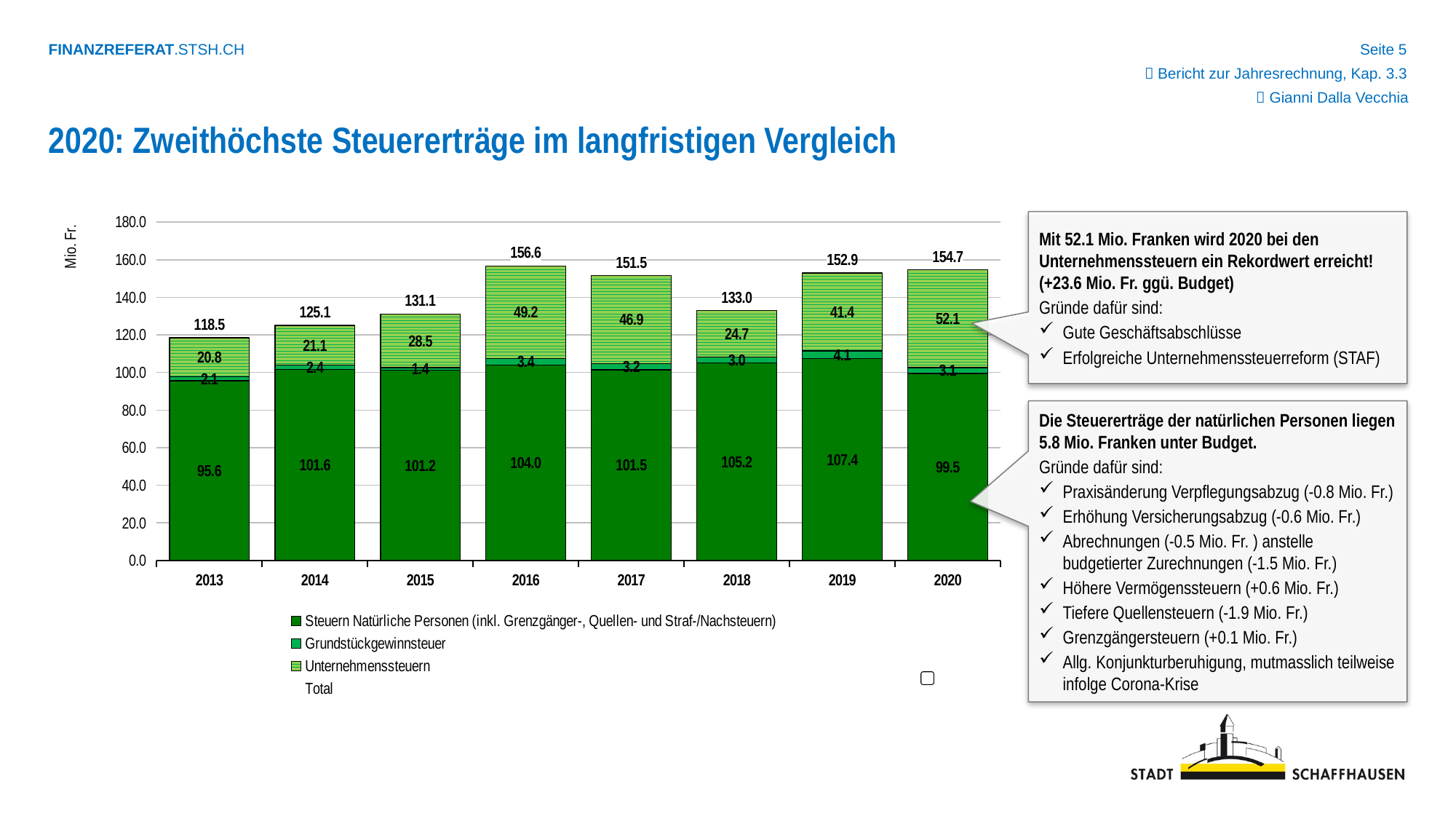
Which year has the lowest total? 2013 What is the difference between the totals for 2020 and 2019? 1.8 What is the total of the stacked bar for 2016? 156.6 How many years are shown on the x axis? 8 What is the value for Unternehmenssteuern in 2020? 52.1 What is the difference between Unternehmenssteuern in 2020 and 2019? 10.7 What is the value for Grundstückgewinnsteuer in 2015? 1.4 What is the value for Steuern Natürliche Personen in 2019? 107.4 Which year has the highest total? 2016 What unit is shown on the y axis? Mio. Fr. What kind of chart is shown? Stacked bar chart Which year has the larger value for Unternehmenssteuern, 2016 or 2017? 2016